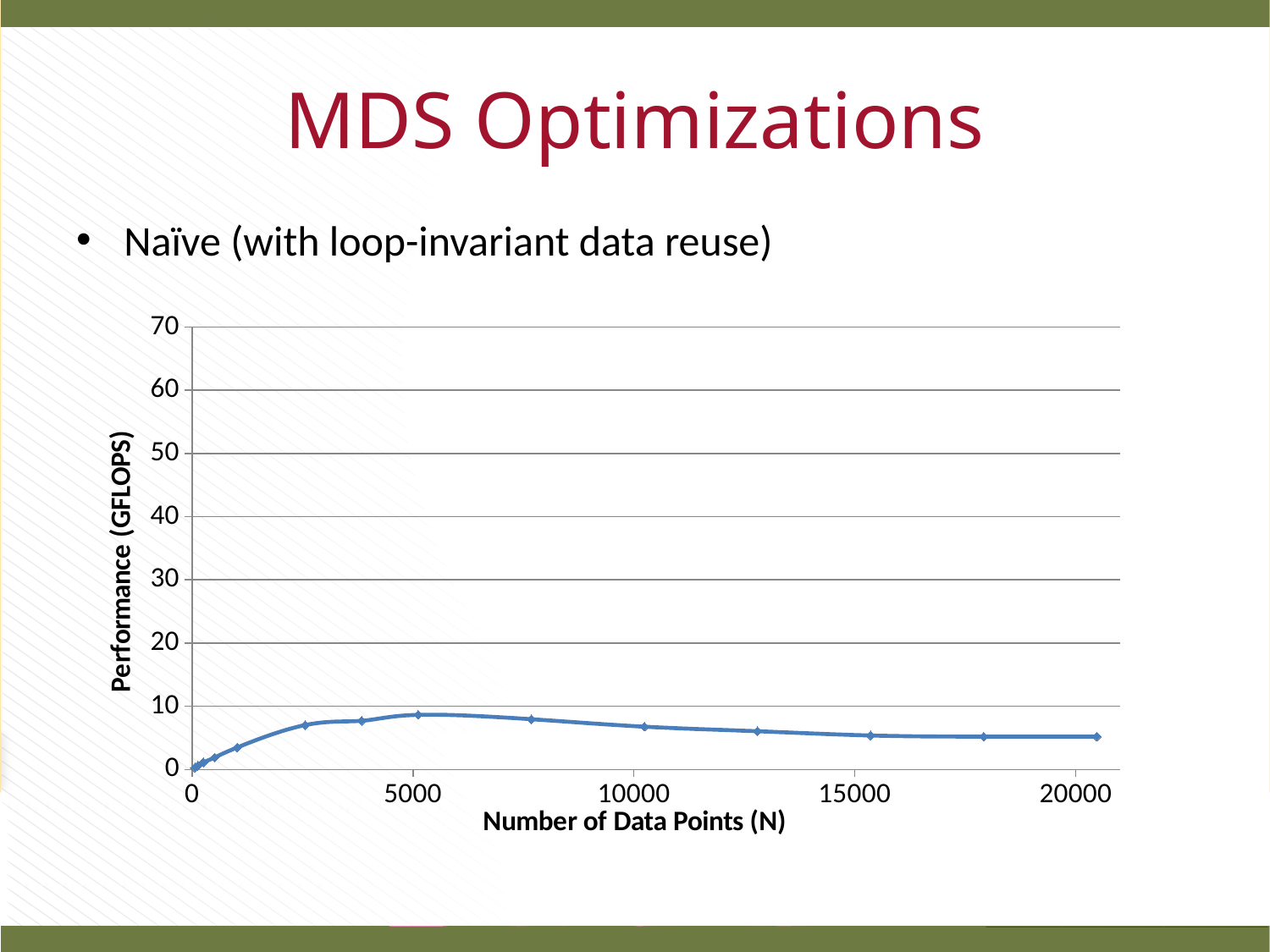
Near which x-axis tick does the line reach its highest value? 5000 Is the peak performance value on the chart greater or less than 10 GFLOPS? less Does performance rise or fall as N increases from about 5000 to 20000? fall Is the performance value at about N=20000 greater or less than 10 GFLOPS? less What kind of chart is shown on the slide? line chart Which is larger: the performance at N=0 or at about N=5000? N=5000 Is the performance value at about N=5000 greater or less than 5 GFLOPS? greater What is the title of the x axis of the chart? Number of Data Points (N) Which is larger: the performance at about N=5000 or at about N=20000? N=5000 Does performance rise or fall as N increases from 0 to about 5000? rise What is the title of the y axis of the chart? Performance (GFLOPS)